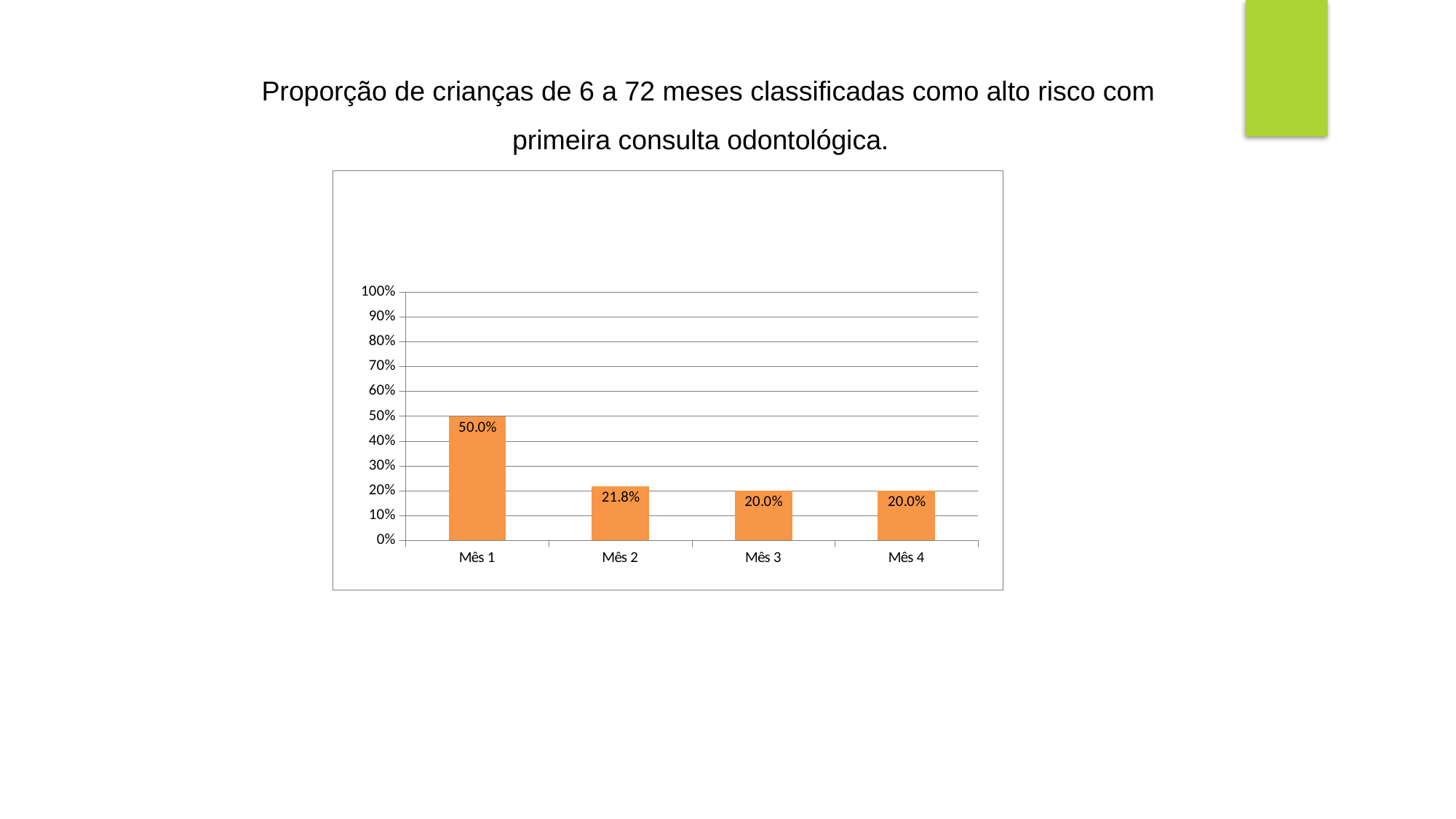
Do the values rise or fall from Mês 1 to Mês 3? fall How many months are shown on the x axis? 4 What is the difference between the values for Mês 1 and Mês 2? 28.2% Is the value for Mês 2 greater or less than 30%? less Which month has the highest value? Mês 1 What is the value for Mês 3? 20.0% What is the difference between the values for Mês 2 and Mês 3? 1.8% Which is larger, the value for Mês 1 or the value for Mês 4? Mês 1 What kind of chart is shown on the slide? bar chart What is the value for Mês 2? 21.8% What is the value for Mês 4? 20.0% What is the value for Mês 1? 50.0%